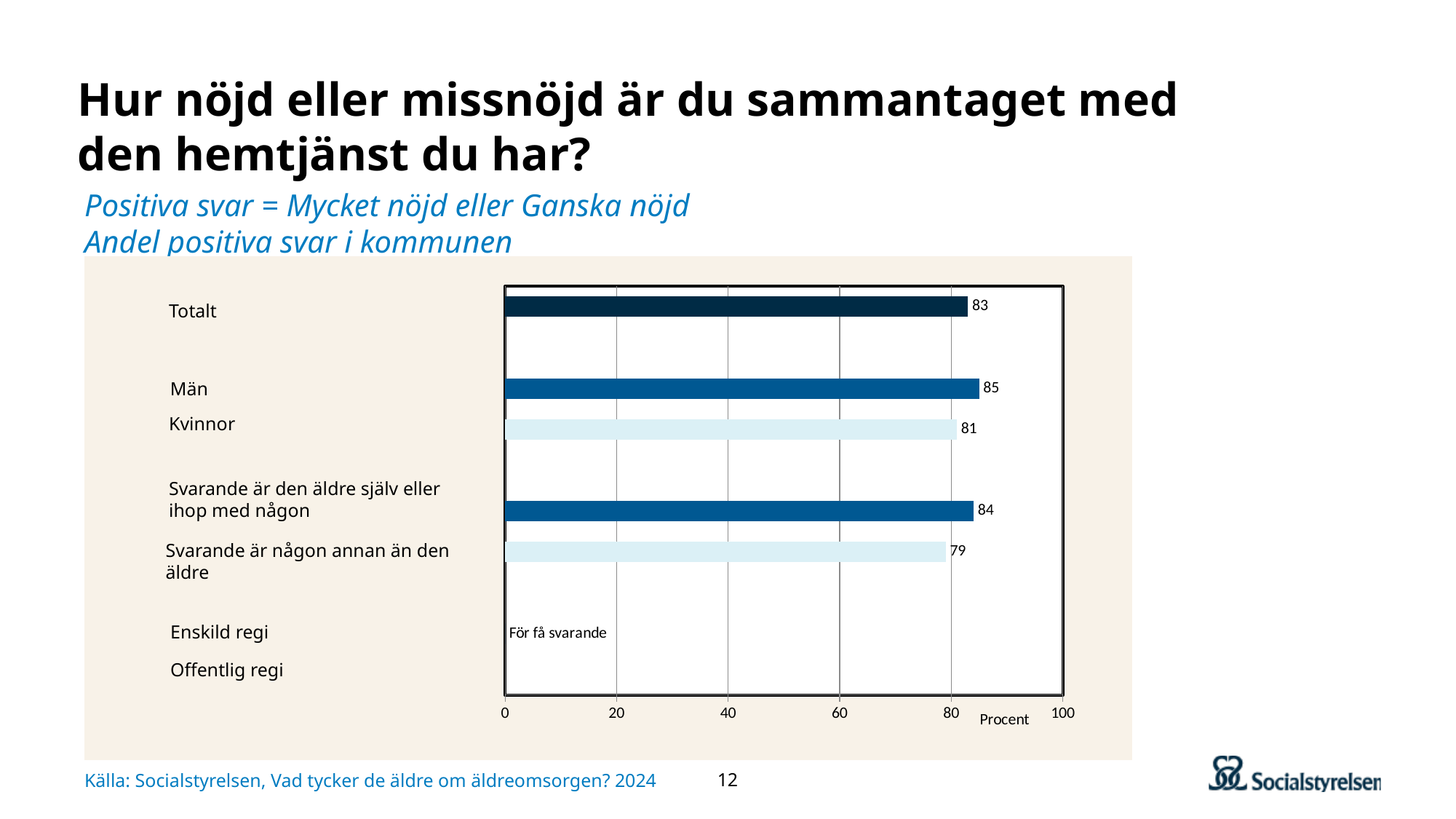
How many categories have a bar plotted in the chart? 5 What is the value for 'Svarande är någon annan än den äldre'? 79 What is the difference between the values for Män and Kvinnor? 4 Which is larger, the value for 'Svarande är den äldre själv eller ihop med någon' or for 'Svarande är någon annan än den äldre'? Svarande är den äldre själv eller ihop med någon Which category has the highest value among the plotted bars? Män What is the value for Kvinnor? 81 What text is shown instead of bars for Enskild regi and Offentlig regi? För få svarande What kind of chart is shown on the slide? bar chart Is the value for Kvinnor greater or less than 80? greater What is the value for Totalt? 83 What is the value for Män? 85 Which category has the lowest value among the plotted bars? Svarande är någon annan än den äldre